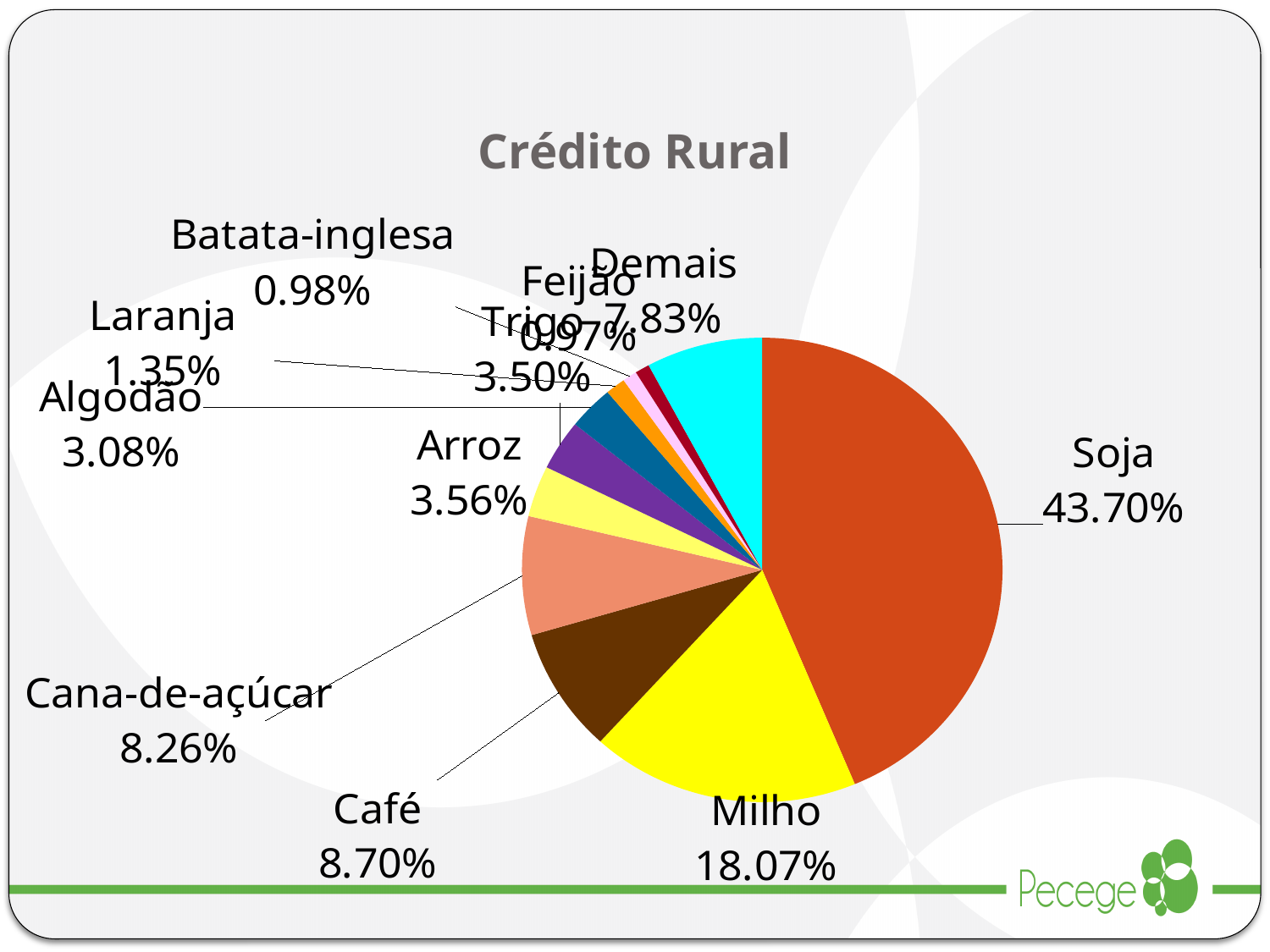
Which is larger, the share for Arroz or for Algodão? Arroz What is the value shown for Cana-de-açúcar? 8.26% How many slices does the pie chart have? 11 What is the title of the chart? Crédito Rural Which category has the largest slice of the pie? Soja What is the value shown for Milho? 18.07% What is the value shown for Demais? 7.83% Which is larger, the share for Café or for Cana-de-açúcar? Café What kind of chart is shown on the slide? pie chart What is the difference between the Café and Cana-de-açúcar shares? 0.44% What share of the pie does Soja represent? 43.70% What is the difference between the Soja and Milho shares? 25.63%